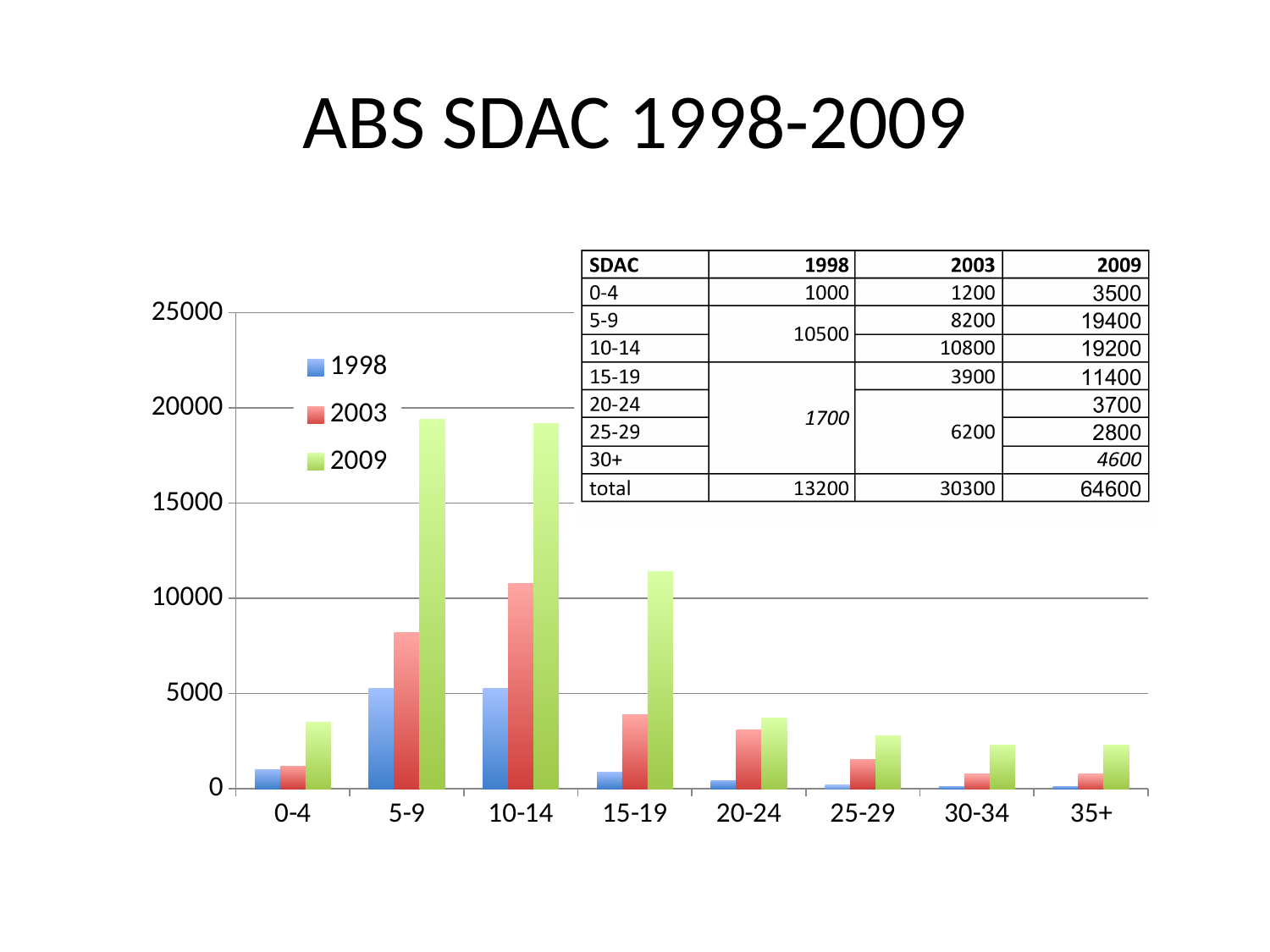
How many series does the chart's legend list? 3 How many age-group categories are shown along the x axis of the chart? 8 Which age group has the highest value for the 2003 series? 10-14 What colour represents the 2009 series in the chart? green What is the 2003 value for the 10-14 age group? 10800 What is the difference between the 2009 and 2003 values for the 15-19 age group? 7500 What is the 2009 value for the 0-4 age group? 3500 What is the 2009 value for the 15-19 age group? 11400 Is the 2003 value for the 15-19 age group greater or less than 5000? less Is the 2009 value for the 5-9 age group greater or less than 15000? greater What kind of chart is shown on the slide? bar chart For the 0-4 age group, which series has the larger value, 2003 or 2009? 2009